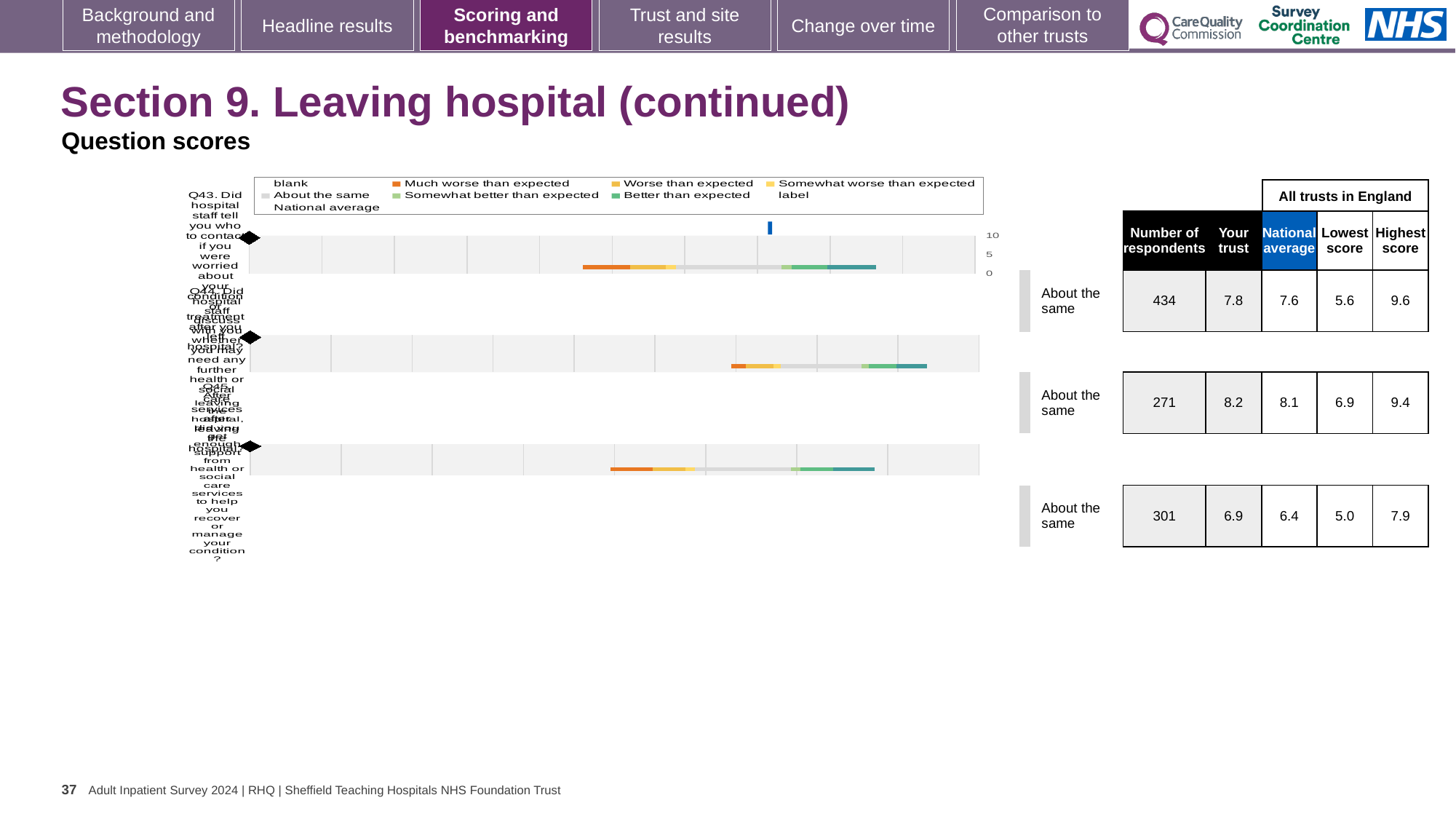
For the second chart, what is the number of respondents? 271 For the first chart (Q43), what is the difference between the highest score and the lowest score across all trusts in England? 4.0 How many question score charts are shown on the slide? 3 What kind of chart is used to show the question scores on this slide? bar chart For the first chart (Q43), what is the number of respondents shown in the table? 434 For the first chart (Q43), which is larger: the 'Your trust' score or the national average? Your trust For the first chart (Q43), what is the 'Your trust' score? 7.8 For the first chart (Q43), what is the national average score? 7.6 What benchmark category is shown next to the third chart? About the same For the third chart, what is the 'Your trust' score? 6.9 In the legend, what colour represents 'Much worse than expected'? orange Which of the three charts has the highest 'Your trust' score? the second chart (8.2)